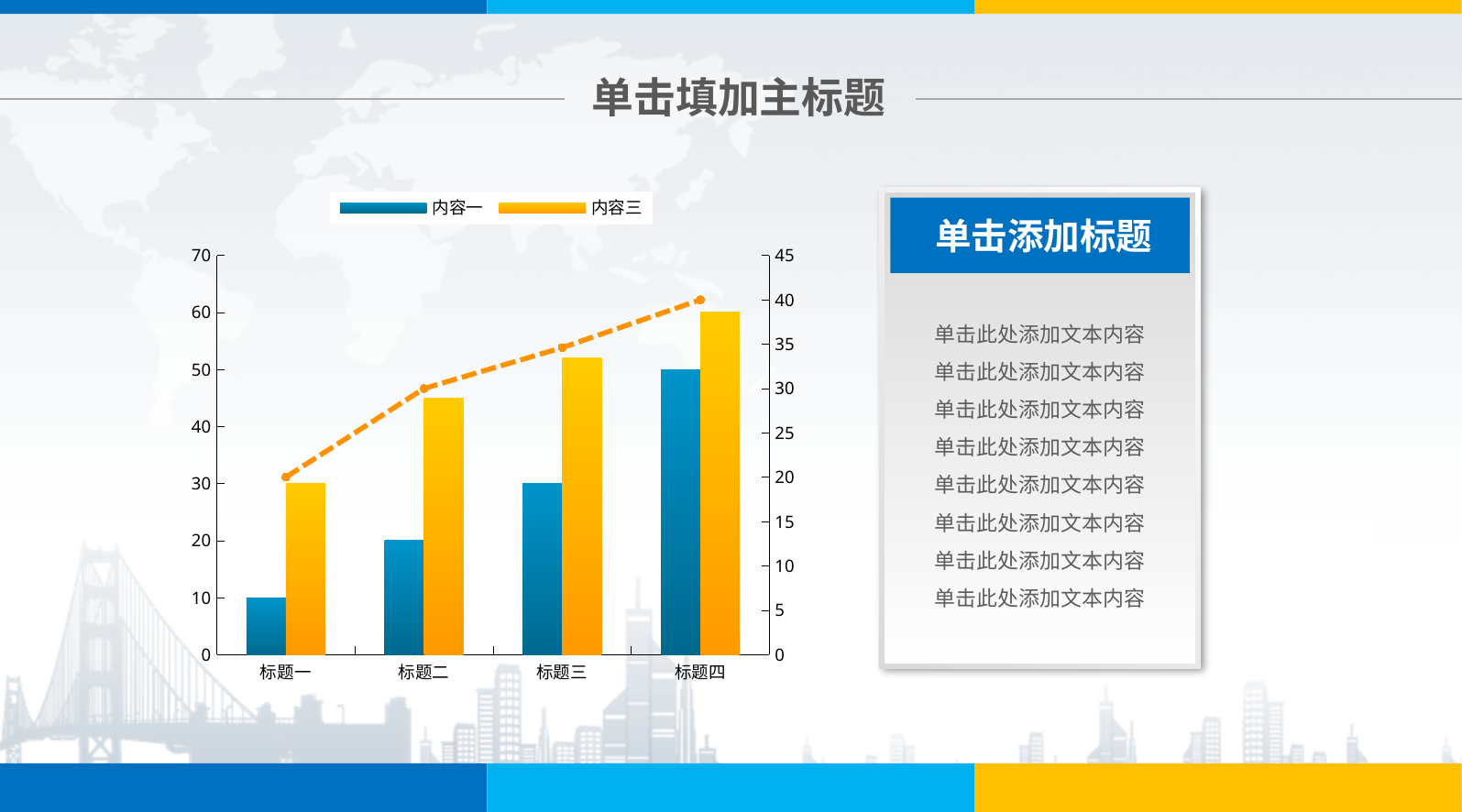
How many series does the legend list? 2 For 标题二, which series has the larger value, 内容一 or 内容三? 内容三 What is the value of 内容三 for 标题四? 60 What is the value of 内容一 for 标题一? 10 Which category has the highest value for 内容一? 标题四 What is the value of 内容一 for 标题四? 50 What is the difference between the 内容一 values for 标题四 and 标题一? 40 Is the value of 内容三 for 标题二 greater or less than 40? greater What is the value of 内容三 for 标题一? 30 Do the values of 内容一 rise or fall from 标题一 to 标题四? rise How many categories are shown on the x axis? 4 Which category has the lowest value for 内容三? 标题一